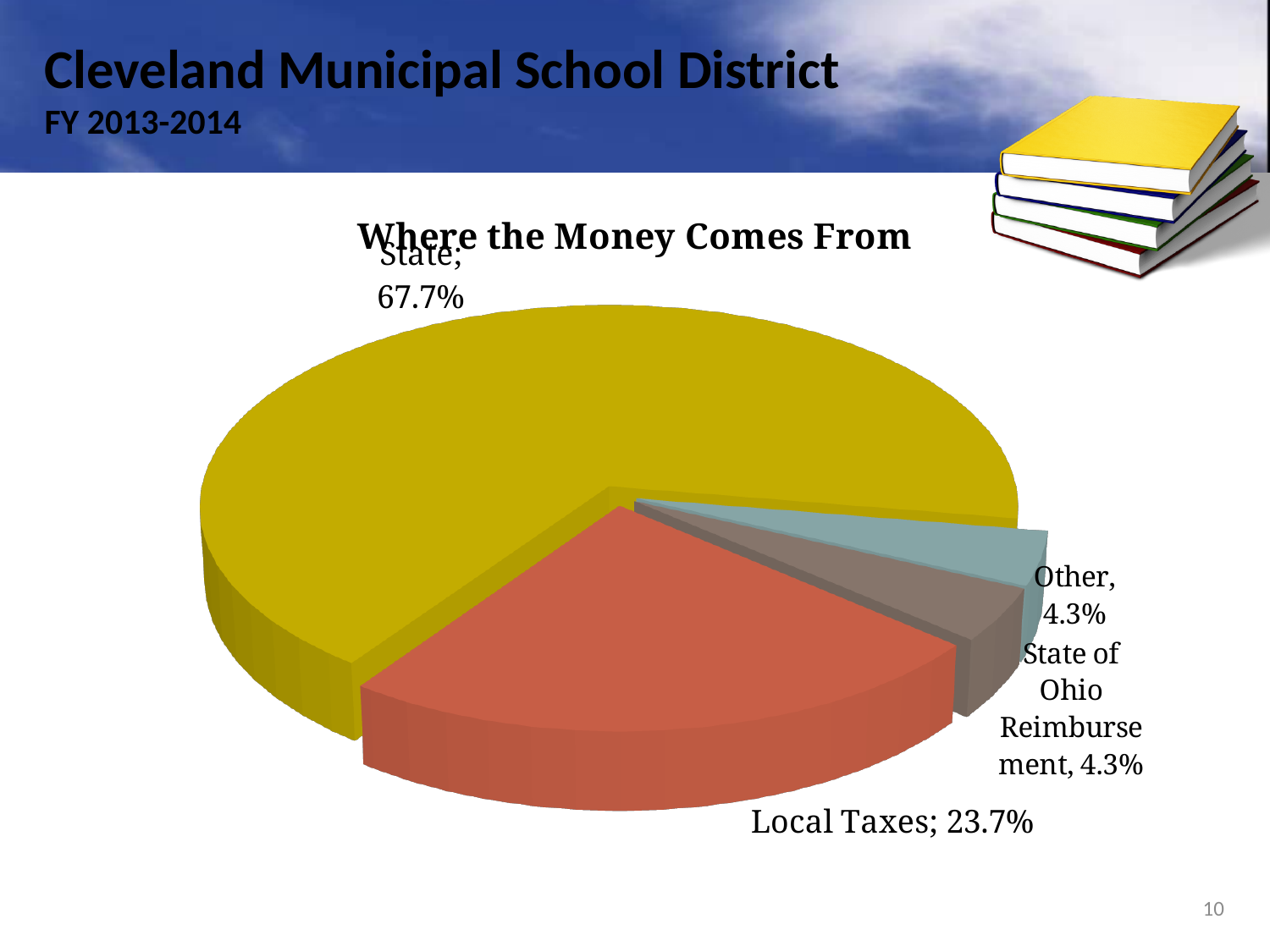
How many slices does the pie chart have? 4 What colour is the State slice of the pie? Yellow What share of the money comes from the State? 67.7% What is the title of the chart? Where the Money Comes From How many percentage points larger is the Local Taxes share than the Other share? 19.4 percentage points What share of the money comes from Local Taxes? 23.7% Which source provides the largest share of the money? State What share of the money comes from Other? 4.3% What kind of chart is shown on the slide? Pie chart What share of the money comes from State of Ohio Reimbursement? 4.3% How many percentage points larger is the State share than the Local Taxes share? 44.0 percentage points Which is larger, the share from Local Taxes or the share from Other? Local Taxes